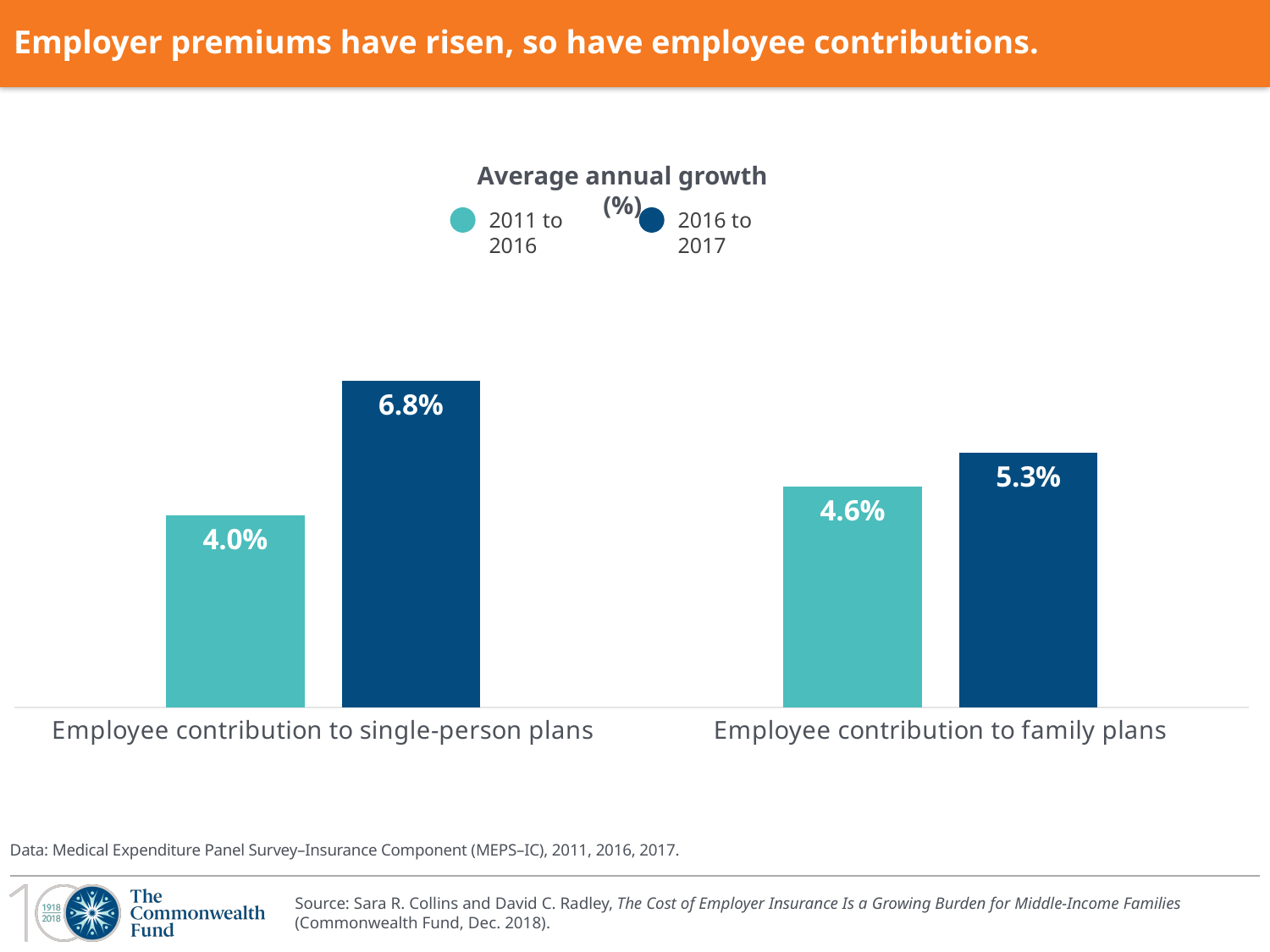
Which bar shows the lowest average annual growth on the chart? Employee contribution to single-person plans, 2011 to 2016 What is the average annual growth for employee contribution to single-person plans from 2016 to 2017? 6.8% What is the difference between the 2016 to 2017 and 2011 to 2016 growth rates for employee contribution to family plans? 0.7% What kind of chart is shown on the slide? Bar chart Which is larger: the 2011 to 2016 growth for single-person plans or the 2011 to 2016 growth for family plans? Family plans How many series does the chart legend list? 2 What is the average annual growth for employee contribution to family plans from 2011 to 2016? 4.6% Which bar shows the highest average annual growth on the chart? Employee contribution to single-person plans, 2016 to 2017 What is the average annual growth for employee contribution to single-person plans from 2011 to 2016? 4.0% How many categories are shown on the x axis of the chart? 2 What is the difference between the 2016 to 2017 and 2011 to 2016 growth rates for employee contribution to single-person plans? 2.8% What is the average annual growth for employee contribution to family plans from 2016 to 2017? 5.3%